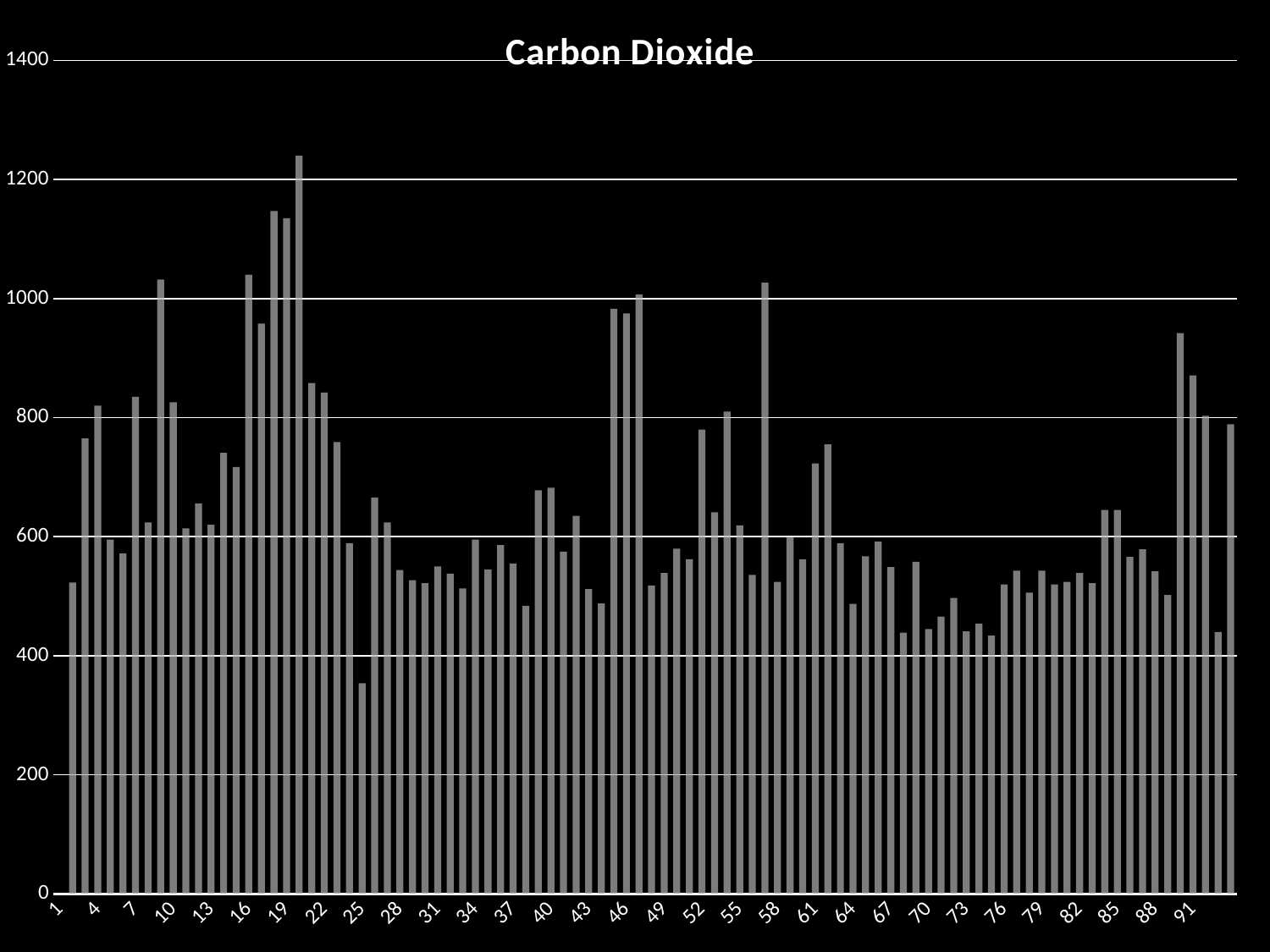
Is the value for category 1 (the first bar) greater or less than 400? greater Is the shortest bar in the chart greater or less than 400? less Which is larger, the first bar or the last bar in the chart? the last bar What kind of chart is shown on the slide? bar chart Is the tallest bar in the chart greater or less than 1200? greater What is the highest value shown on the vertical axis? 1400 What is the title of the chart? Carbon Dioxide